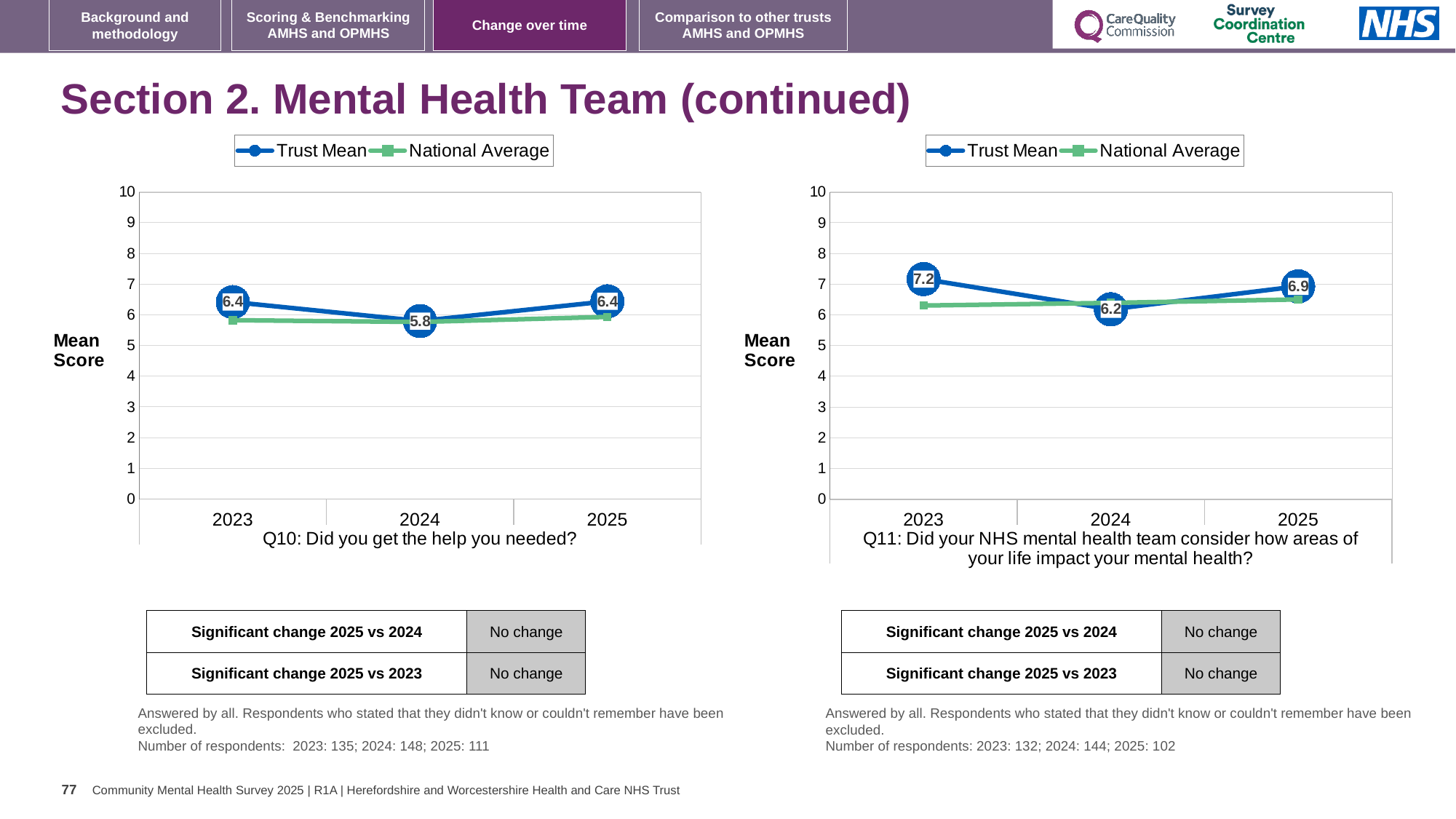
How many years are plotted on the x axis of the Q10 chart on the left? 3 In the Q10 chart on the left, what is the Trust Mean score for 2024? 5.8 In the Q11 chart on the right, which year has the highest Trust Mean score? 2023 What type of chart is the Q10 chart on the left? Line chart In the Q11 chart on the right, what is the Trust Mean score for 2023? 7.2 In the Q10 chart on the left, is the National Average value for 2023 greater or less than 5? greater In the Q10 chart on the left, which year has the lowest Trust Mean score? 2024 How many series does the legend of the Q11 chart on the right list? 2 In the Q11 chart on the right, what is the difference between the Trust Mean scores for 2023 and 2024? 1.0 In the Q11 chart on the right, what is the Trust Mean score for 2025? 6.9 In the Q11 chart on the right, is the Trust Mean score higher in 2023 or in 2024? 2023 In the Q10 chart on the left, what is the difference between the Trust Mean scores for 2025 and 2024? 0.6